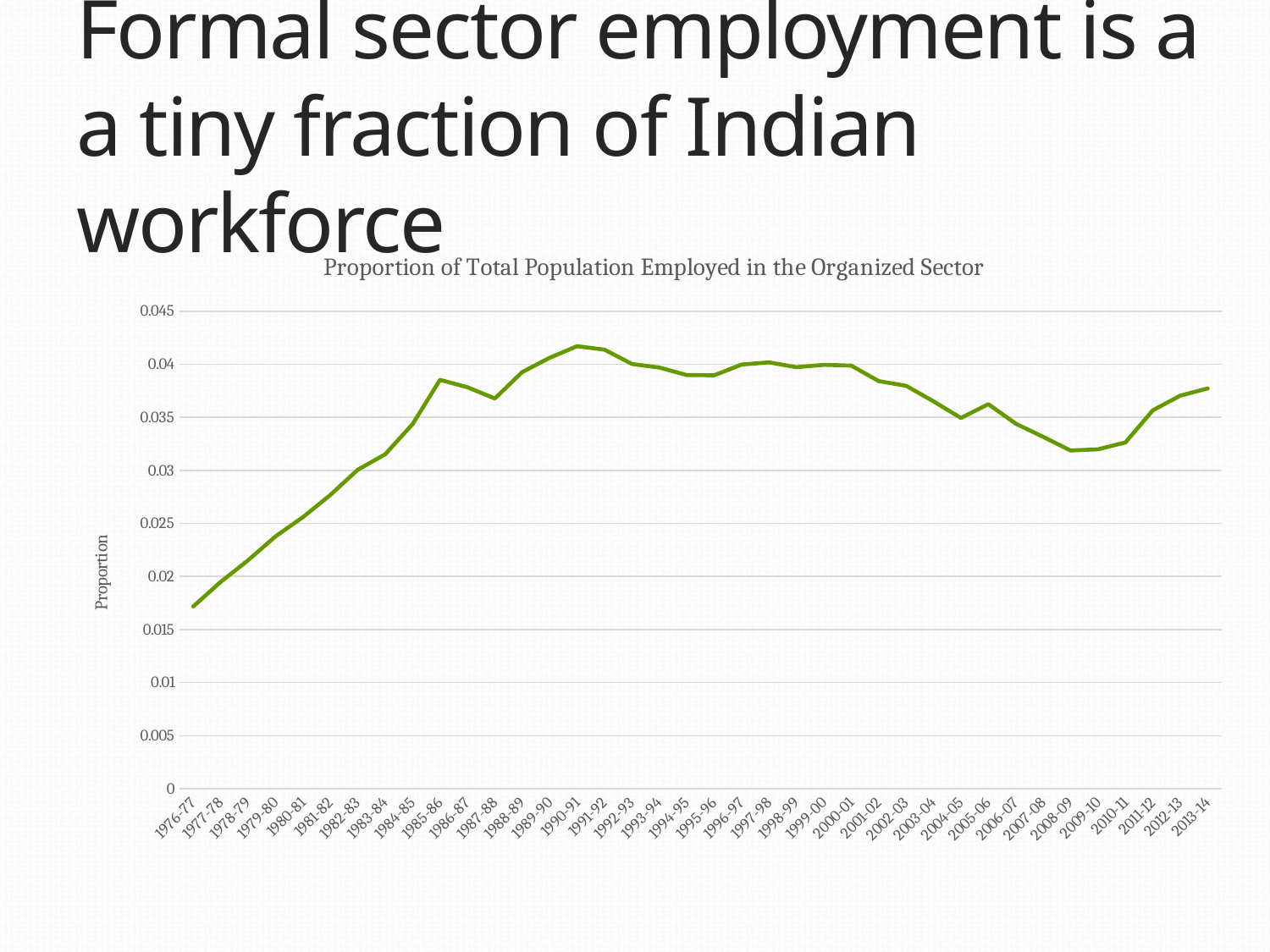
What is the title of the chart? Proportion of Total Population Employed in the Organized Sector In which year is the proportion highest? 1990-91 How many years are plotted along the x axis of the chart? 38 Is the value for 2013-14 greater or less than 0.035? greater What kind of chart is shown on the slide? line chart What is the label on the vertical axis of the chart? Proportion Is the value for 1976-77 greater or less than 0.02? less In which year is the proportion lowest? 1976-77 Is the value for 1990-91 greater or less than 0.04? greater Does the proportion rise or fall from 1976-77 to 1990-91? rise Which year has the larger proportion, 1976-77 or 2013-14? 2013-14